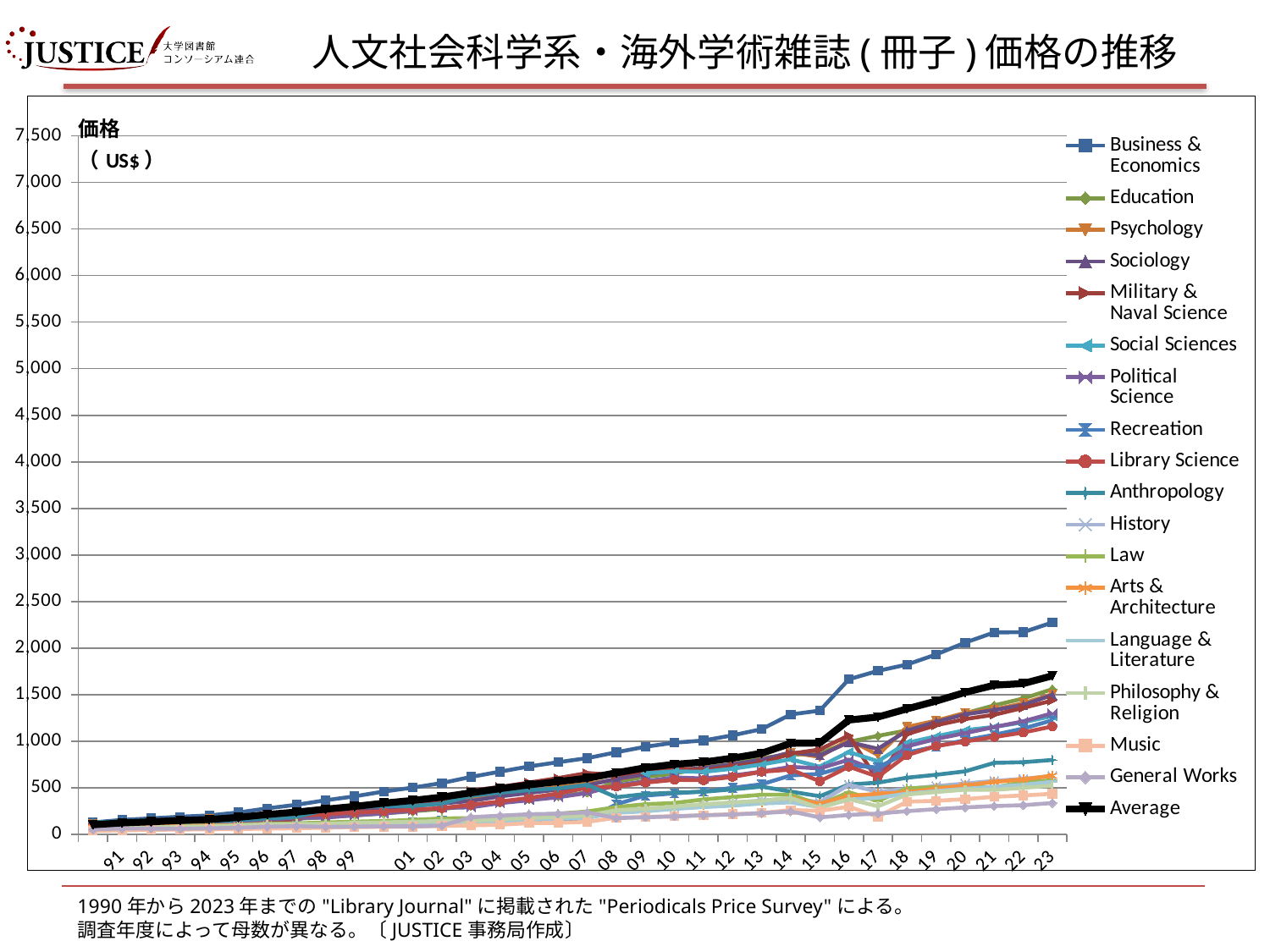
How many series does the legend list? 18 Is the value for Business & Economics in 23 greater or less than 2,000? greater Do the values for Business & Economics generally rise or fall from 91 to 23? rise Is the value for Average in 10 greater or less than 1,000? less Is the value for Business & Economics in 14 greater or less than 1,000? greater What unit is shown for the vertical axis? US$ Which series has the highest value in 23? Business & Economics What kind of chart is shown on the slide? line chart Which is larger in 23, Business & Economics or Average? Business & Economics Which series has the lowest value in 23? General Works